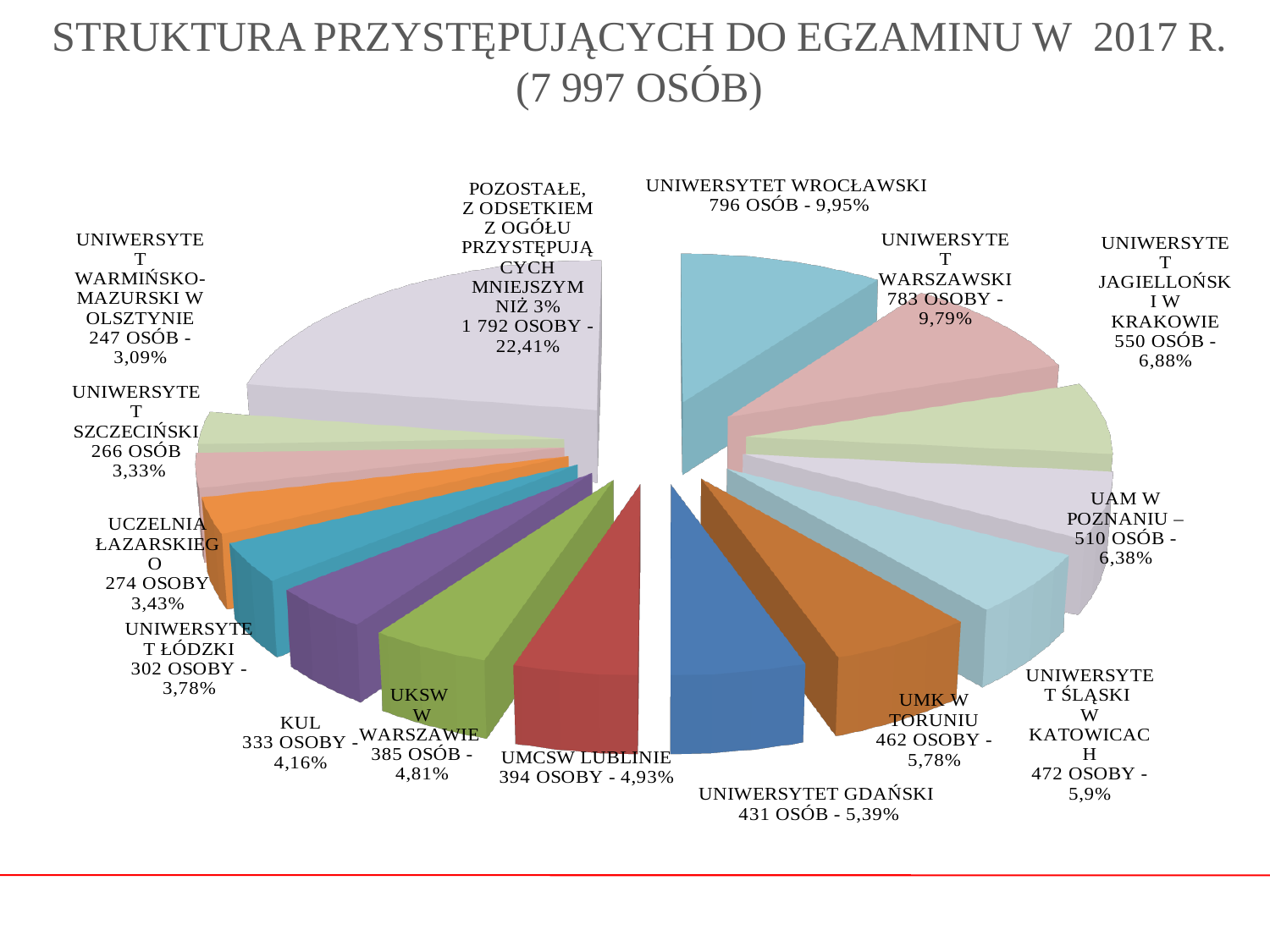
What percentage share is shown for Uniwersytet Śląski w Katowicach? 5,9% What percentage share does Uniwersytet Warszawski have in the pie chart? 9,79% What kind of chart is shown on the slide? pie chart How many people from Uniwersytet Wrocławski took the exam in 2017? 796 What is the percentage share of Uniwersytet Gdański? 5,39% Which named university has the smallest slice in the pie chart? Uniwersytet Warmińsko-Mazurski w Olsztynie (247 osób - 3,09%) Which has more exam takers, KUL or UKSW w Warszawie? UKSW w Warszawie What is the total number of people taking the exam according to the slide title? 7 997 Which slice of the pie chart is the largest? Pozostałe (1 792 osoby - 22,41%) What is the difference in the number of people between Uniwersytet Wrocławski and Uniwersytet Warszawski? 13 How many slices does the pie chart have? 15 What is the number of people shown for UMK w Toruniu? 462